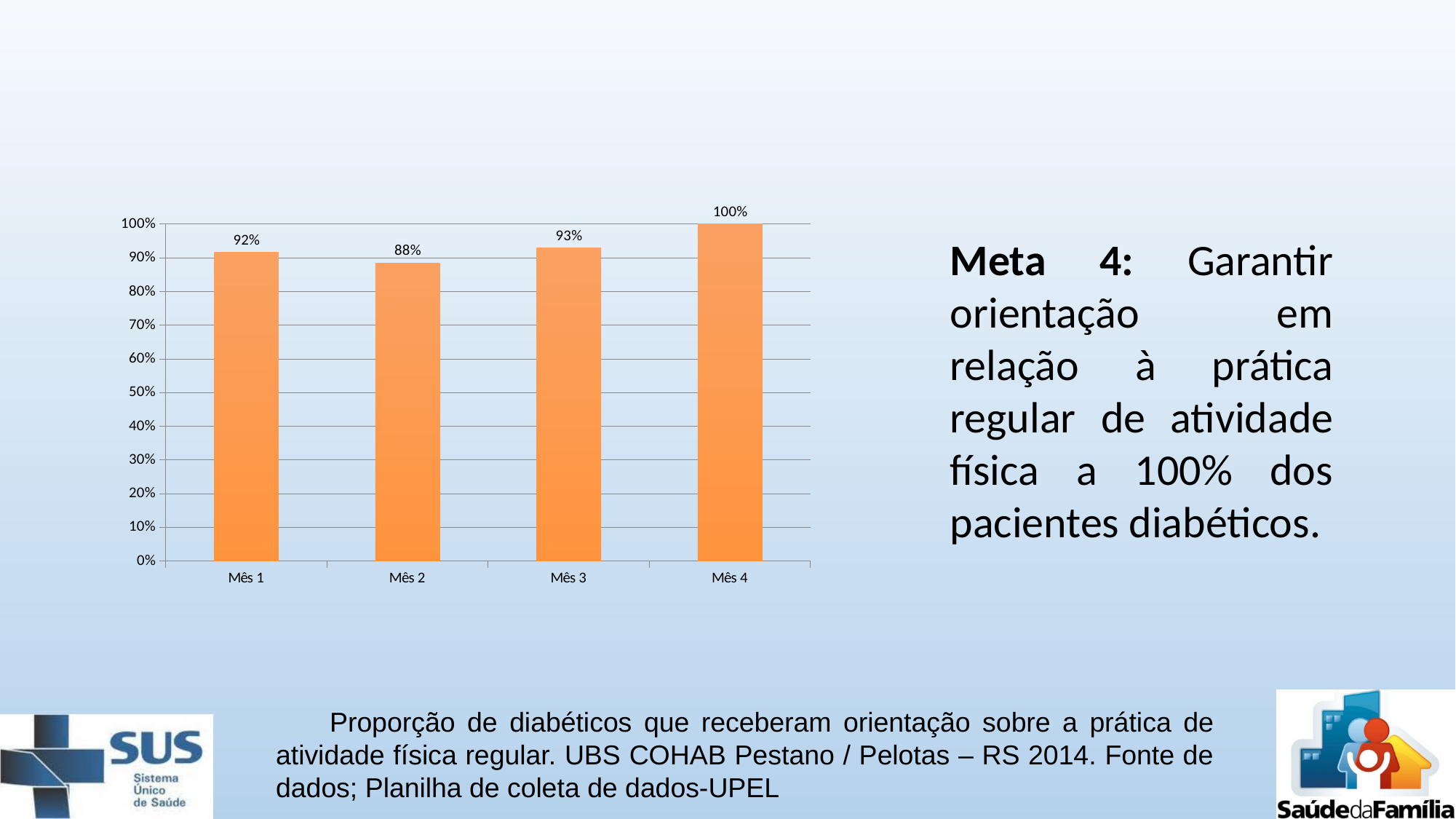
What is the difference between the values for Mês 4 and Mês 2? 12% What is the difference between the values for Mês 3 and Mês 1? 1% What is the value for Mês 1? 92% Which month has the highest value? Mês 4 Which is larger, the value for Mês 1 or the value for Mês 2? Mês 1 What colour are the bars in the chart? Orange What kind of chart is shown on the slide? Bar chart How many months are shown on the x axis? 4 What is the value for Mês 2? 88% Which month has the lowest value? Mês 2 What is the value for Mês 4? 100% What is the value for Mês 3? 93%